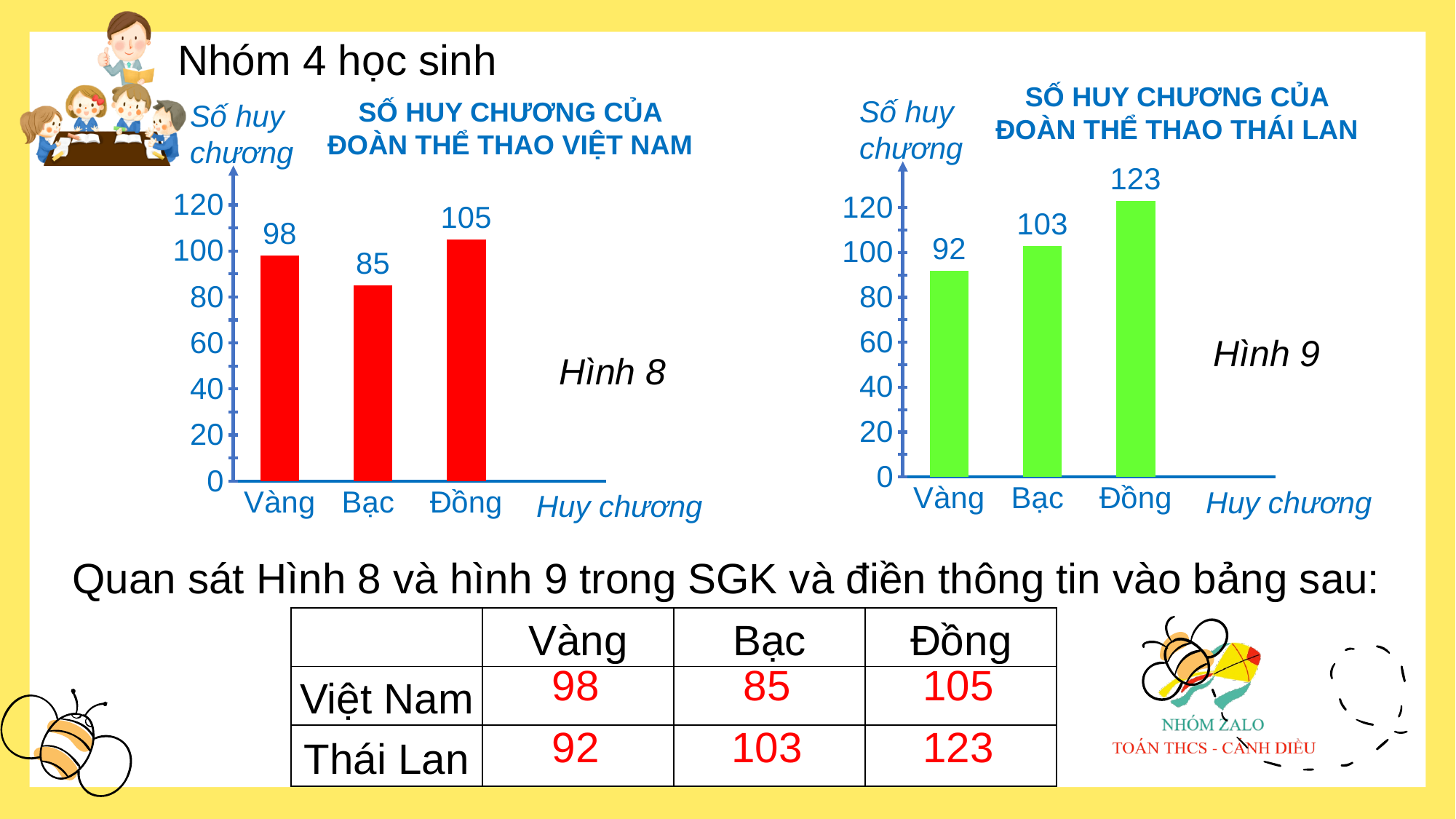
In the chart 'SỐ HUY CHƯƠNG CỦA ĐOÀN THỂ THAO THÁI LAN' (Hình 9), which is larger, the value for Bạc or the value for Vàng? Bạc In the chart 'SỐ HUY CHƯƠNG CỦA ĐOÀN THỂ THAO VIỆT NAM' (Hình 8), what is the value for Vàng? 98 In the chart 'SỐ HUY CHƯƠNG CỦA ĐOÀN THỂ THAO THÁI LAN' (Hình 9), is the value for Đồng greater or less than 120? greater In the chart 'SỐ HUY CHƯƠNG CỦA ĐOÀN THỂ THAO VIỆT NAM' (Hình 8), what is the difference between the values for Đồng and Bạc? 20 How many categories are shown in the chart 'SỐ HUY CHƯƠNG CỦA ĐOÀN THỂ THAO VIỆT NAM' (Hình 8)? 3 In the chart 'SỐ HUY CHƯƠNG CỦA ĐOÀN THỂ THAO VIỆT NAM' (Hình 8), which category has the lowest value? Bạc In the chart 'SỐ HUY CHƯƠNG CỦA ĐOÀN THỂ THAO THÁI LAN' (Hình 9), what is the value for Bạc? 103 In the chart 'SỐ HUY CHƯƠNG CỦA ĐOÀN THỂ THAO THÁI LAN' (Hình 9), what is the difference between the values for Đồng and Vàng? 31 What kind of chart is 'SỐ HUY CHƯƠNG CỦA ĐOÀN THỂ THAO THÁI LAN' (Hình 9)? bar chart What colour are the bars in the chart 'SỐ HUY CHƯƠNG CỦA ĐOÀN THỂ THAO VIỆT NAM' (Hình 8)? red In the chart 'SỐ HUY CHƯƠNG CỦA ĐOÀN THỂ THAO VIỆT NAM' (Hình 8), which category has the highest value? Đồng In the chart 'SỐ HUY CHƯƠNG CỦA ĐOÀN THỂ THAO THÁI LAN' (Hình 9), which category has the lowest value? Vàng